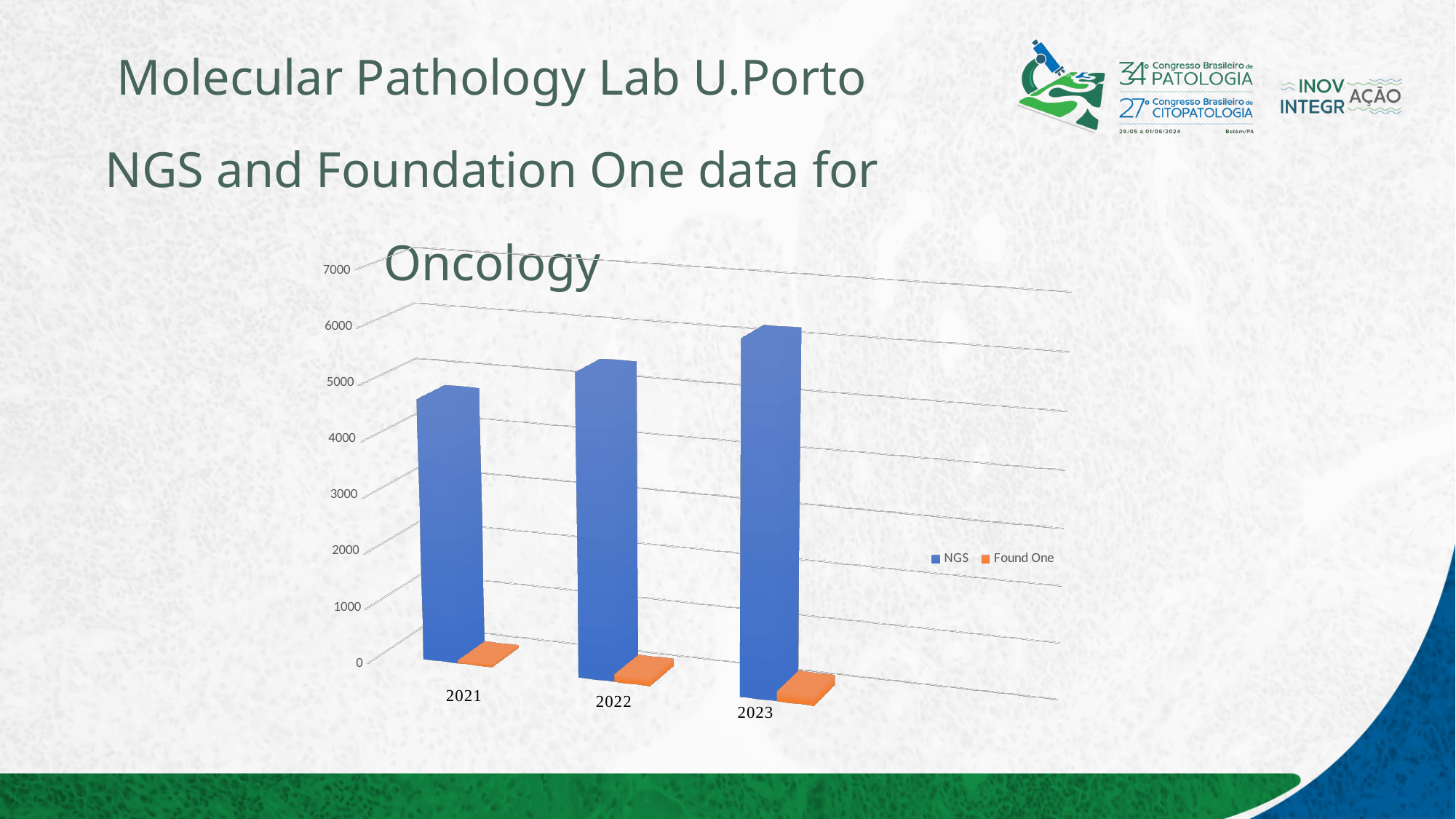
How many series does the chart legend list? 2 What kind of chart is shown on the slide? bar chart Which year has the lowest NGS value? 2021 Is the NGS value for 2021 greater or less than 4000? greater In 2022, which series has the larger value, NGS or Found One? NGS Which year has the highest NGS value? 2023 What colour are the NGS bars in the chart? blue Is the Found One value for 2023 greater or less than 1000? less How many years are shown on the x axis of the chart? 3 What are the two series named in the legend? NGS and Found One Do the NGS values rise or fall from 2021 to 2023? rise